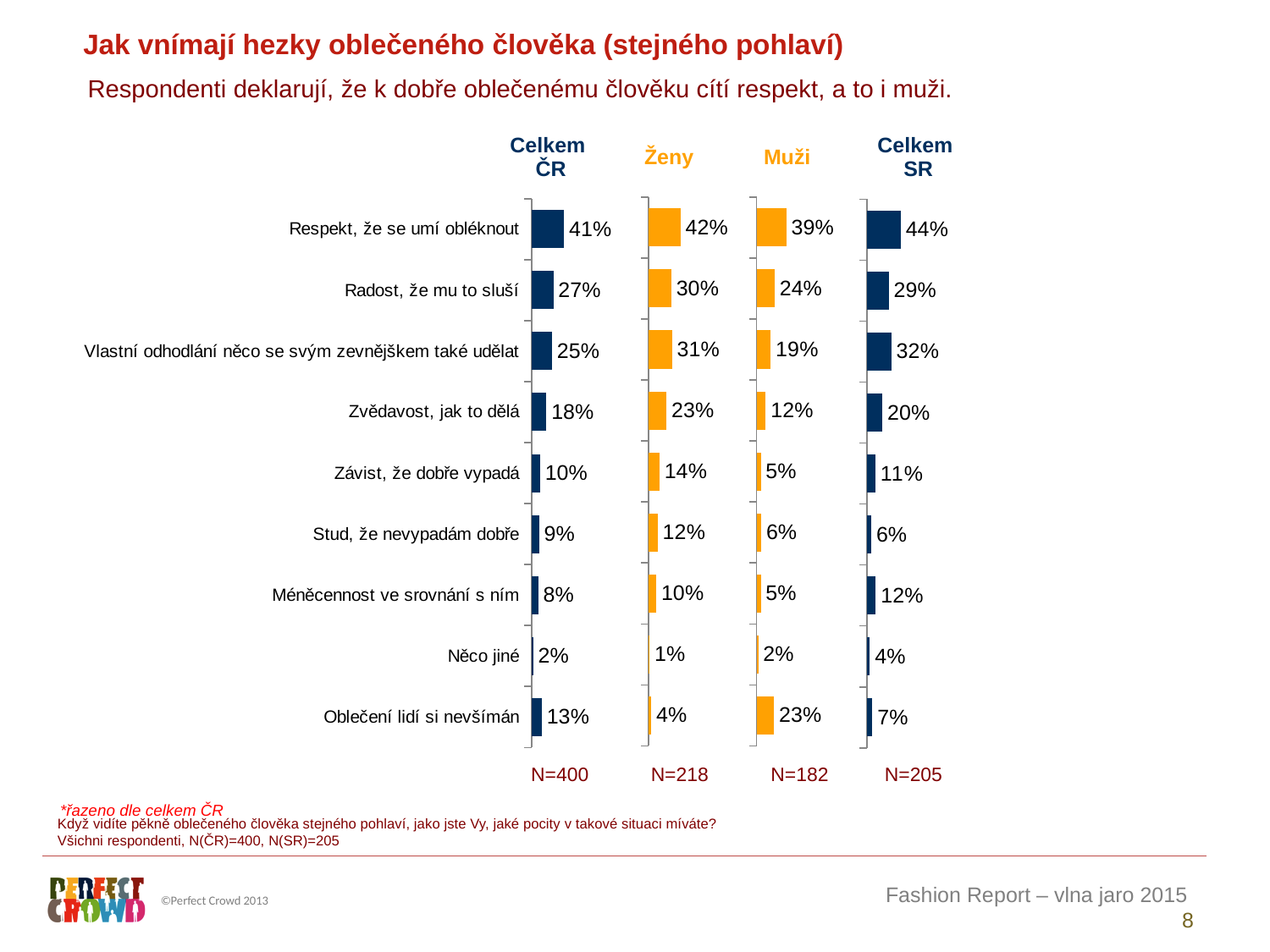
For "Závist, že dobře vypadá", which is larger: the Ženy value or the Muži value? Ženy What is the sample size (N) shown under the Muži chart? N=182 In the Muži chart, what is the value for "Oblečení lidí si nevšímán"? 23% How many categories are shown in the Celkem ČR chart? 9 In the Celkem SR chart, which category has the highest value? Respekt, že se umí obléknout What is the difference between the Ženy and Muži values for "Zvědavost, jak to dělá"? 11 percentage points In the Celkem SR chart, what is the value for "Zvědavost, jak to dělá"? 20% In the Ženy chart, what is the value for "Vlastní odhodlání něco se svým zevnějškem také udělat"? 31% In the Celkem ČR chart, what is the value for "Respekt, že se umí obléknout"? 41% What is the difference between the Celkem SR and Celkem ČR values for "Oblečení lidí si nevšímán"? 6 percentage points What type of chart is used on this slide? Bar chart In the Ženy chart, which category has the lowest value? Něco jiné